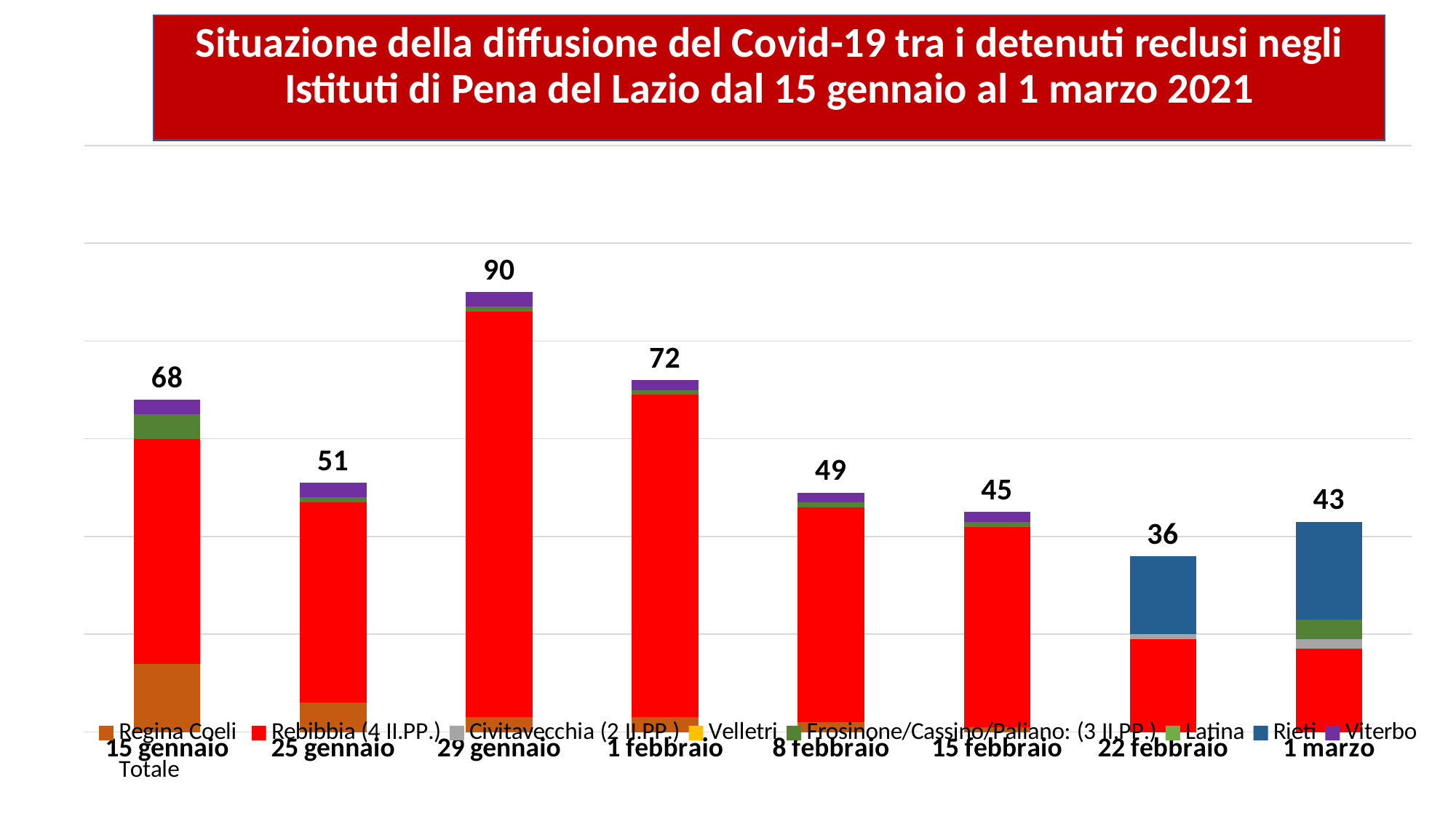
Which total is larger, 8 febbraio or 15 febbraio? 8 febbraio What is the total shown above the bar for 22 febbraio? 36 What is the total number of detainees shown for 29 gennaio? 90 Which date has the highest total? 29 gennaio How many series does the legend list? 9 What is the total shown for 1 marzo? 43 What kind of chart is shown on the slide? Stacked bar chart What is the difference between the totals for 29 gennaio and 1 febbraio? 18 Which date has the lowest total? 22 febbraio How many dates are shown on the x axis? 8 What is the difference between the totals for 15 gennaio and 25 gennaio? 17 Which series is shown in blue in the legend? Rieti